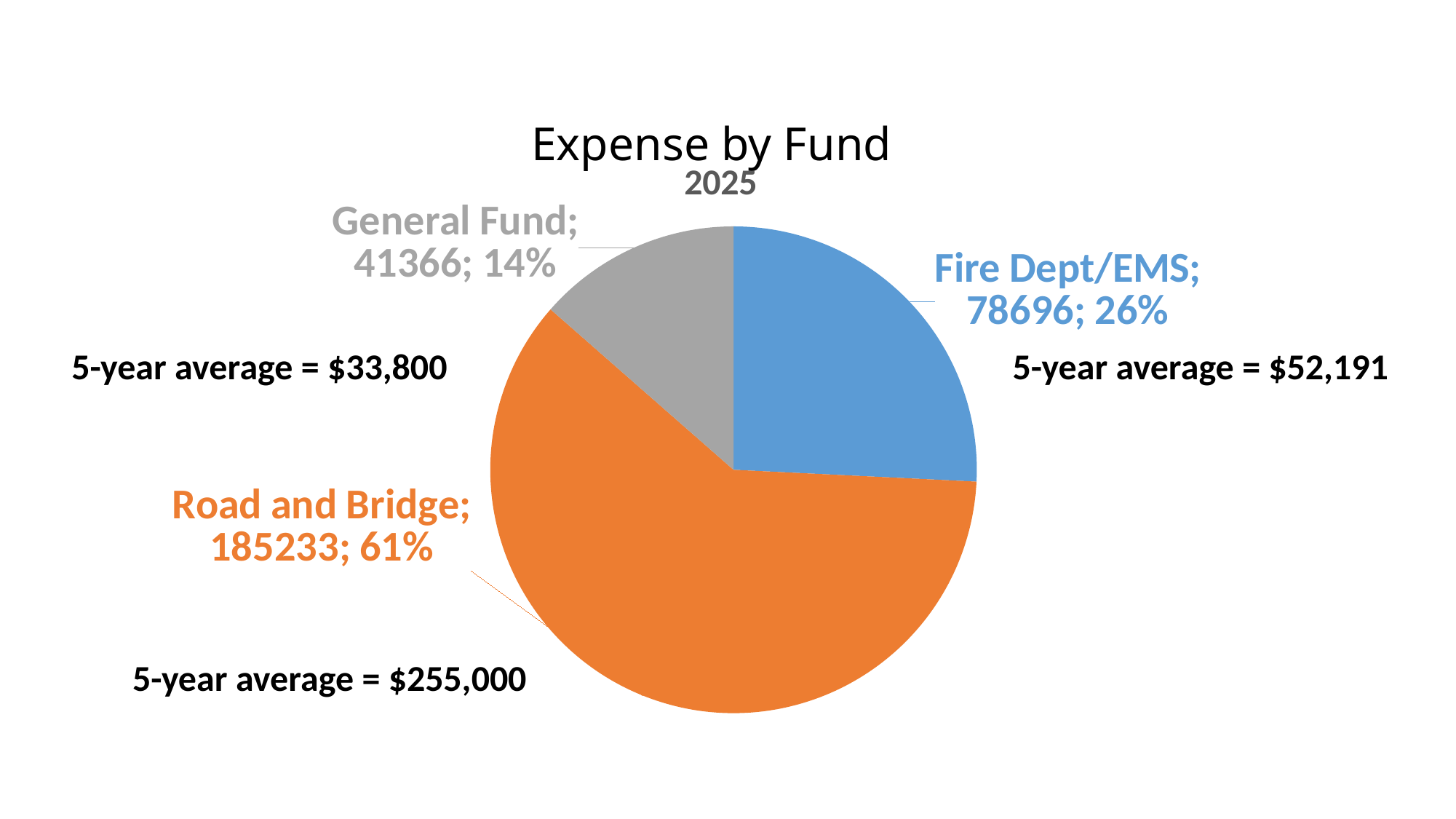
What is the difference between the Fire Dept/EMS expense and the General Fund expense? 37330 What share of the pie does General Fund represent? 14% What is the expense value for General Fund? 41366 What share of the pie does Road and Bridge represent? 61% How many slices does the pie chart have? 3 What type of chart is shown on the slide? pie chart Which fund has the smallest expense? General Fund What is the expense value for Fire Dept/EMS? 78696 What is the expense value for Road and Bridge? 185233 Which fund has the largest expense? Road and Bridge Which is larger, the Fire Dept/EMS expense or the General Fund expense? Fire Dept/EMS What is the title of the chart? Expense by Fund